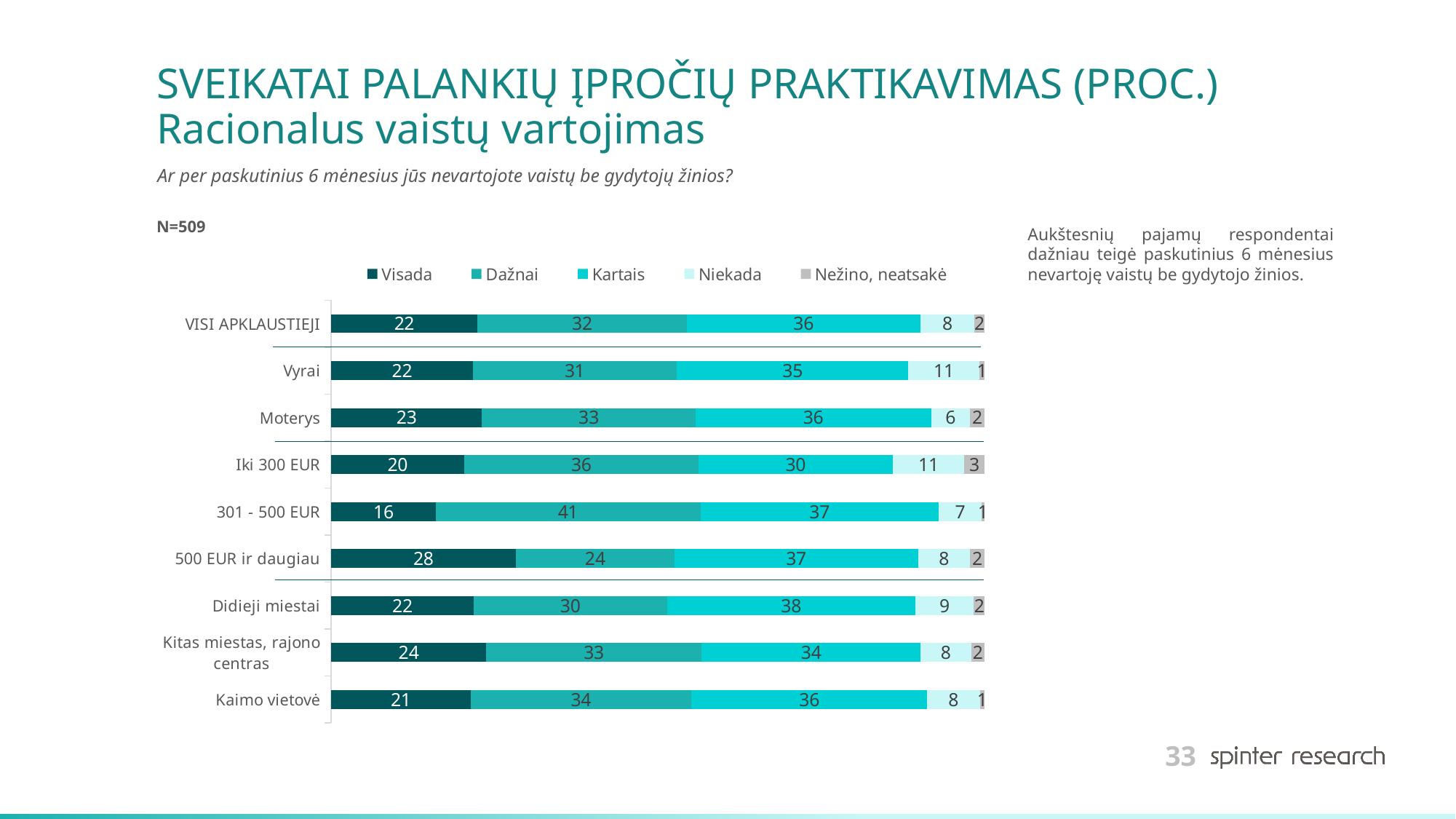
Which category has the lowest "Visada" value? 301 - 500 EUR What kind of chart is shown on the slide? Stacked bar chart Which category has the highest "Visada" value? 500 EUR ir daugiau How many series does the legend list? 5 How many categories are shown on the chart? 9 What is the "Niekada" value for "Vyrai"? 11 What is the difference between the "Kartais" values for "Didieji miestai" and "Iki 300 EUR"? 8 What is the "Dažnai" value for "301 - 500 EUR"? 41 What is the total of the stacked bar for "Kaimo vietovė"? 100 What is the sample size (N) shown on the slide? N=509 What is the "Visada" value for "500 EUR ir daugiau"? 28 Which is larger: the "Dažnai" value for "Moterys" or for "Vyrai"? Moterys